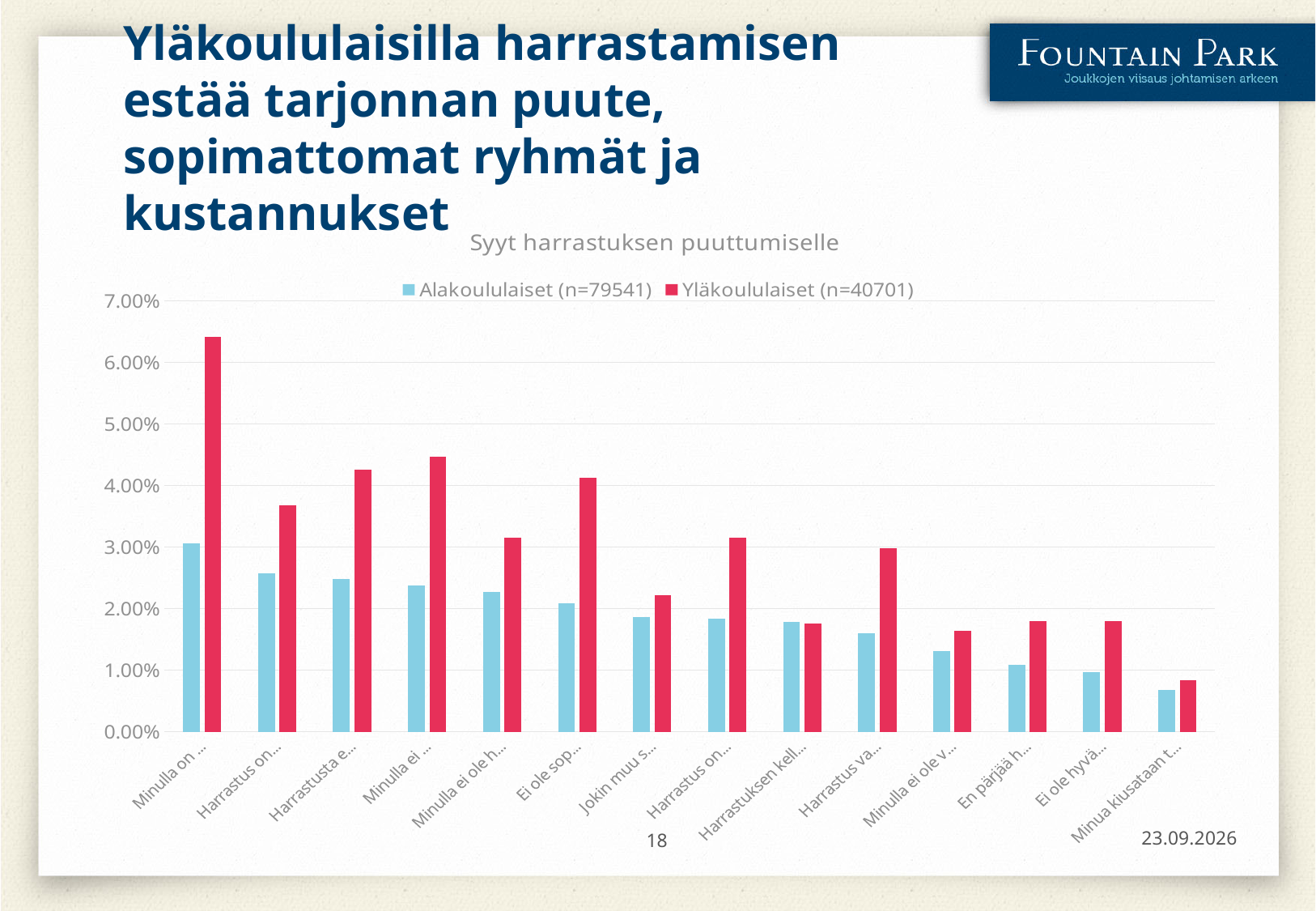
How many series does the chart's legend list? 2 Which series contains the single highest bar in the chart? Yläkoululaiset (n=40701) In the first (leftmost) category, which series has the larger value, Alakoululaiset or Yläkoululaiset? Yläkoululaiset Is the Yläkoululaiset value for the last (rightmost) category greater or less than 1.00%? less What kind of chart is shown on the slide? bar chart Which two series are listed in the chart's legend? Alakoululaiset (n=79541) and Yläkoululaiset (n=40701) What is the title of the chart? Syyt harrastuksen puuttumiselle How many categories are plotted along the x axis of the chart? 14 Is the Alakoululaiset value for the last (rightmost) category greater or less than 1.00%? less Do the Alakoululaiset values generally rise or fall from left to right along the x axis? fall Is the Yläkoululaiset value for the second category from the left greater or less than 3.00%? greater